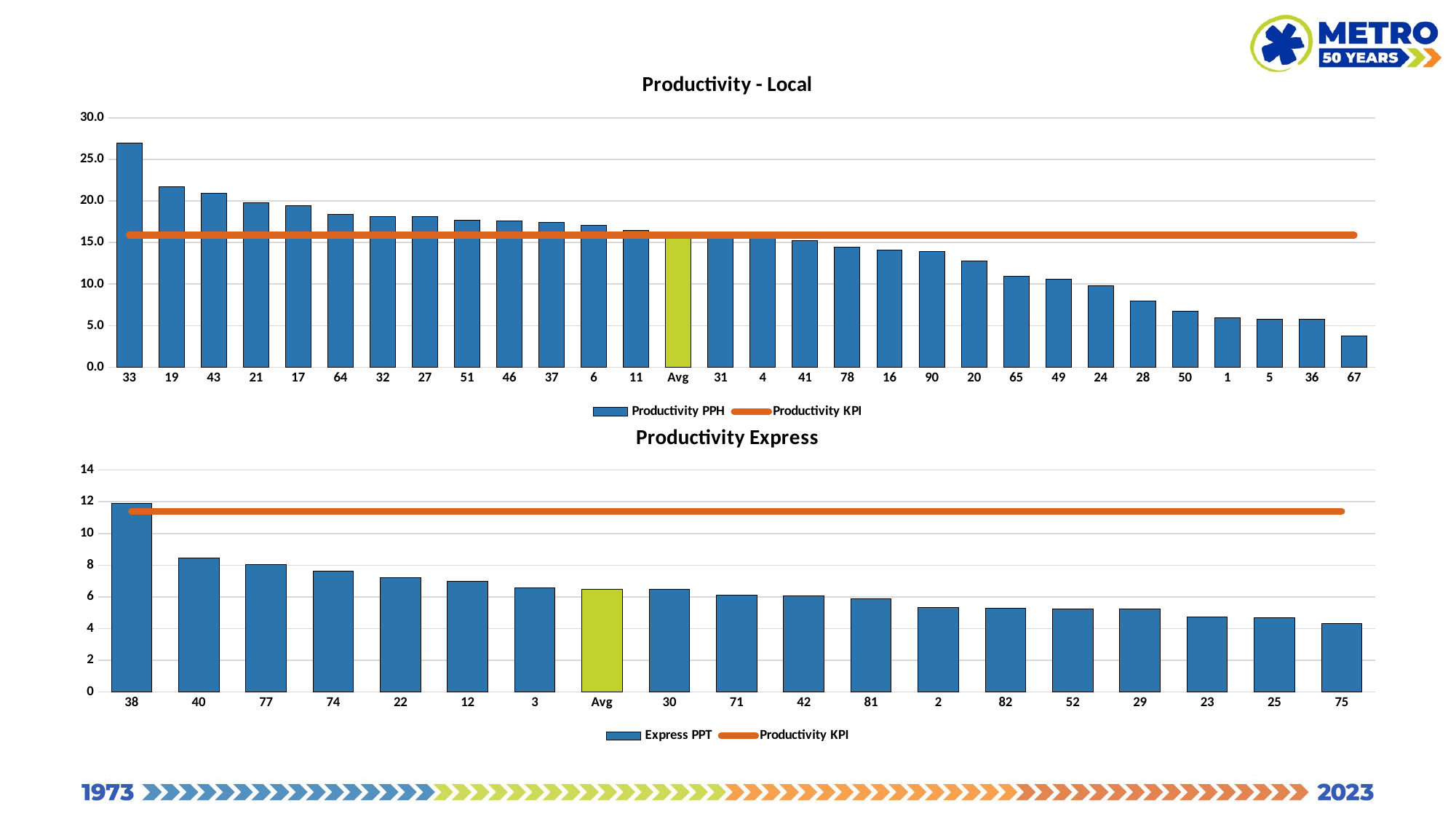
In the 'Productivity - Local' chart, is the value for 67 greater or less than 5.0? less In the 'Productivity - Local' chart, is the value for 33 greater or less than 25.0? greater How many series does the legend of the 'Productivity - Local' chart list? 2 In the 'Productivity Express' chart, which category has the lowest Express PPT? 75 What kind of chart is the 'Productivity - Local' chart? combination bar and line chart In the 'Productivity Express' chart, what colour is the Productivity KPI line? orange How many categories are shown on the x axis of the 'Productivity - Local' chart? 30 In the 'Productivity Express' chart, do the bar values rise or fall from left to right along the x axis? fall In the 'Productivity Express' chart, which category has the highest Express PPT? 38 In the 'Productivity - Local' chart, which category has the highest Productivity PPH? 33 In the 'Productivity - Local' chart, which category has the lowest Productivity PPH? 67 In the 'Productivity Express' chart, is the value for 38 greater or less than 10? greater